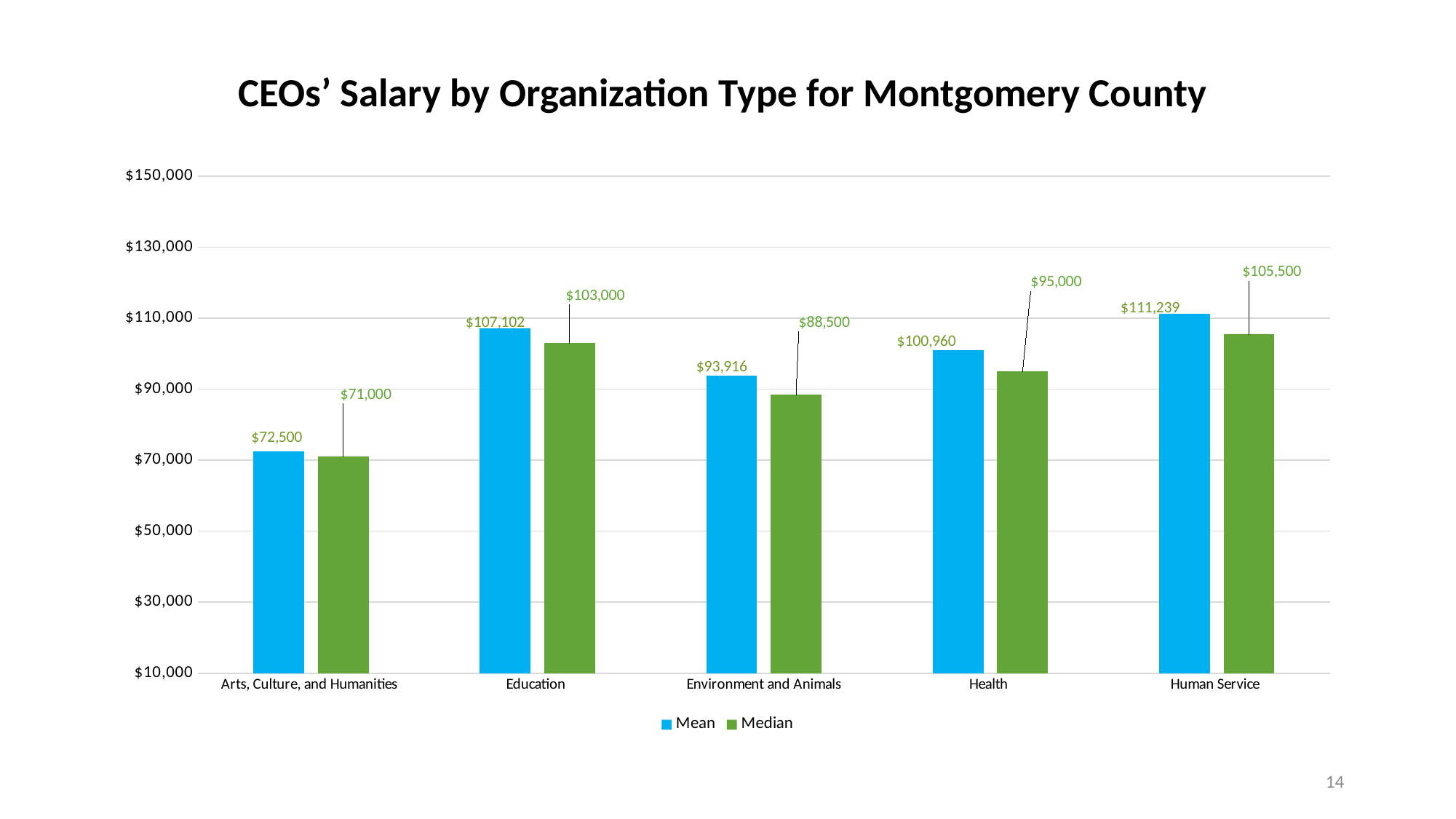
Which organization type has the lowest median CEO salary? Arts, Culture, and Humanities What colour are the Median bars? Green How many organization types are shown on the x axis? 5 How many series does the legend list? 2 What is the median CEO salary for Environment and Animals? $88,500 What is the mean CEO salary for Education? $107,102 What kind of chart is shown on the slide? Bar chart Which is larger for Education: the mean or the median CEO salary? Mean What is the difference between the mean and median CEO salary for Health? $5,960 Is the mean CEO salary for Environment and Animals greater or less than $90,000? greater Which organization type has the highest mean CEO salary? Human Service What is the median CEO salary for Human Service? $105,500